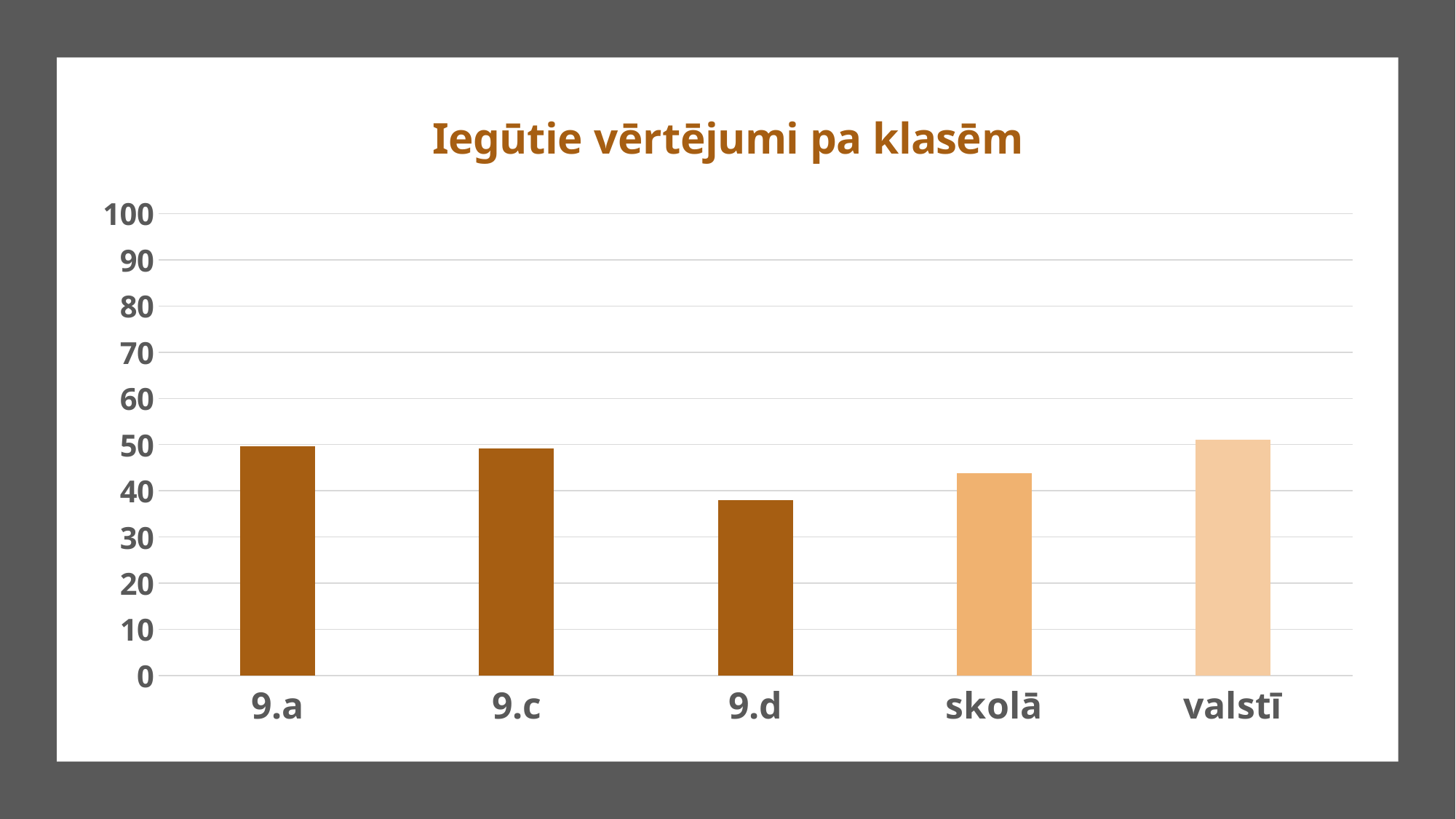
Is the value for skolā greater or less than 50? less What is the title of the chart? Iegūtie vērtējumi pa klasēm Which category has the lowest bar in the chart? 9.d Is the value for 9.d greater or less than 30? greater What kind of chart is shown on the slide? bar chart Which is larger, the value for skolā or the value for 9.d? skolā Is the value for 9.d greater or less than 40? less How many categories are shown on the x axis of the chart? 5 Which is larger, the value for valstī or the value for skolā? valstī Which is larger, the value for 9.a or the value for 9.d? 9.a